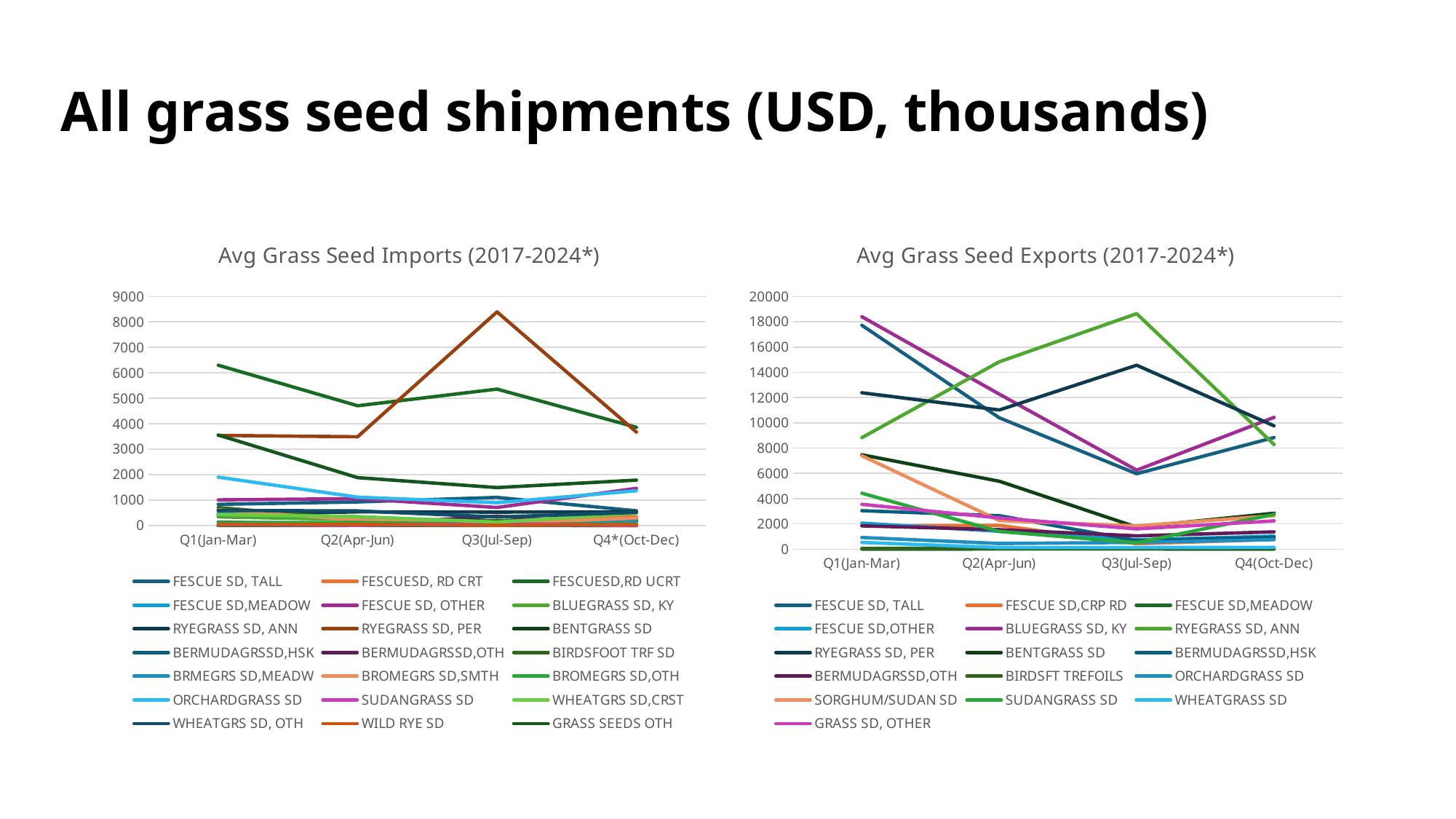
In the Avg Grass Seed Exports (2017-2024*) chart, which series has the highest value in Q3(Jul-Sep)? RYEGRASS SD, ANN In the Avg Grass Seed Imports (2017-2024*) chart, is the highest value plotted in Q1(Jan-Mar) greater or less than 6000? greater In the Avg Grass Seed Exports (2017-2024*) chart, is the peak value of RYEGRASS SD, ANN in Q3(Jul-Sep) greater or less than 18000? greater In the Avg Grass Seed Imports (2017-2024*) chart, is the peak value of RYEGRASS SD, PER in Q3(Jul-Sep) greater or less than 8000? greater In the Avg Grass Seed Imports (2017-2024*) chart, in which quarter does the highest plotted value occur? Q3(Jul-Sep) What kind of chart is the Avg Grass Seed Imports (2017-2024*) chart? line chart In the Avg Grass Seed Imports (2017-2024*) chart, which series has the highest value in Q3(Jul-Sep)? RYEGRASS SD, PER How many quarters are plotted on the x axis of the Avg Grass Seed Exports (2017-2024*) chart? 4 What is the title of the left chart on the slide? Avg Grass Seed Imports (2017-2024*) How many series does the legend of the Avg Grass Seed Imports (2017-2024*) chart list? 21 What is the maximum value shown on the y axis of the Avg Grass Seed Exports (2017-2024*) chart? 20000 How many series does the legend of the Avg Grass Seed Exports (2017-2024*) chart list? 16